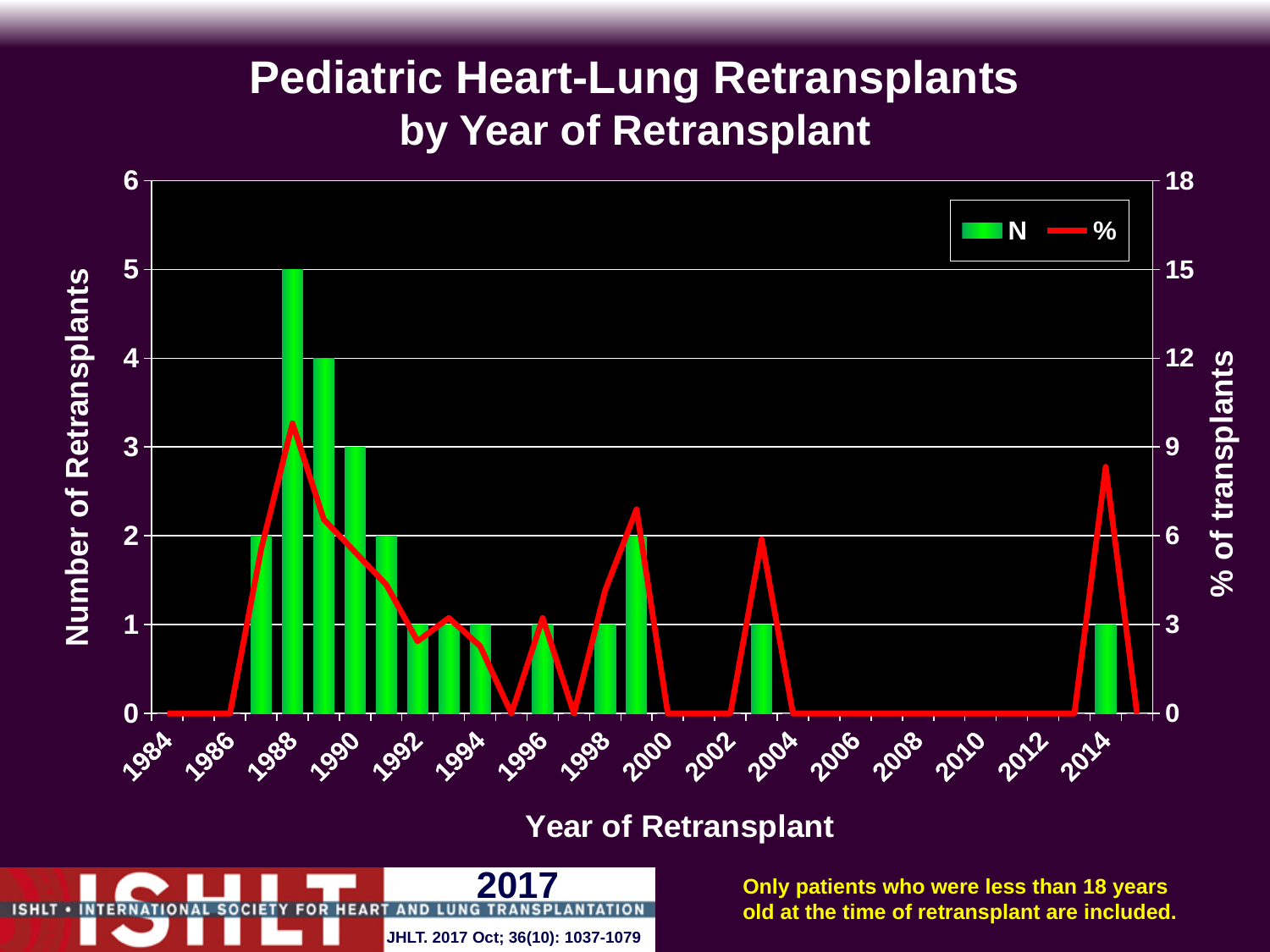
What type of chart is shown on the slide? Combined bar and line chart What is the number of retransplants (N) in 1990? 3 What is the label of the left vertical axis? Number of Retransplants How many series does the legend list? 2 Is the % of transplants value for 2014 greater or less than 9? less Is the % of transplants value for 1988 greater or less than 9? greater What is the number of retransplants (N) in 1989? 4 What is the number of retransplants (N) in 1988? 5 Which year has the highest number of retransplants (N)? 1988 Which year has more retransplants (N), 1989 or 1990? 1989 What is the difference in the number of retransplants (N) between 1988 and 1989? 1 What is the number of retransplants (N) in 2014? 1